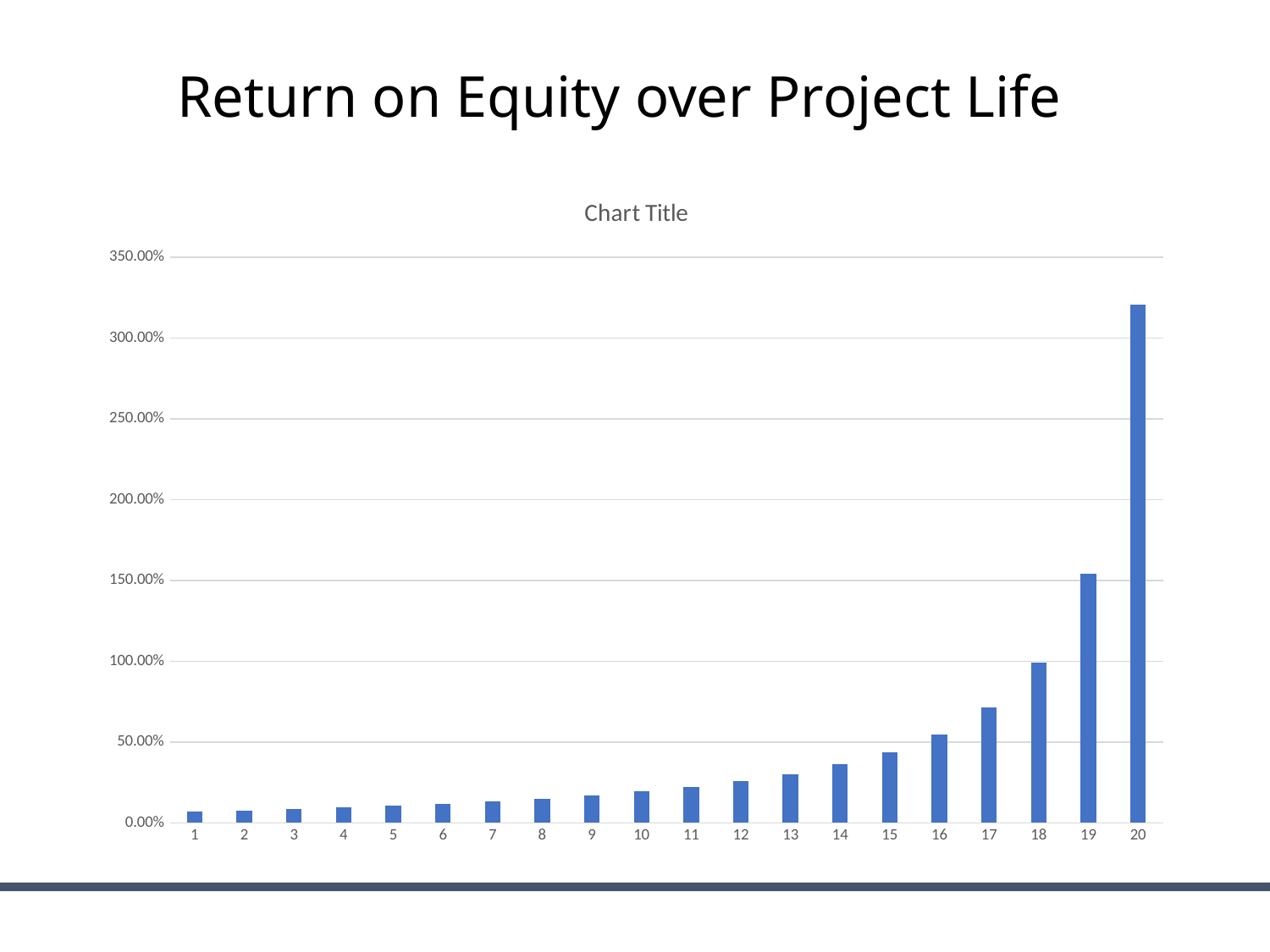
Which is larger, the value for category 19 or the value for category 20? 20 Is the value for category 15 greater or less than 50.00%? less Is the value for category 17 greater or less than 100.00%? less Is the value for category 19 greater or less than 100.00%? greater Do the values generally rise or fall from category 1 to category 20? rise What is the title printed above the chart area? Chart Title Which is larger, the value for category 5 or the value for category 15? 15 Which category has the highest value? 20 How many categories are plotted along the x axis? 20 What kind of chart is shown on the slide? bar chart